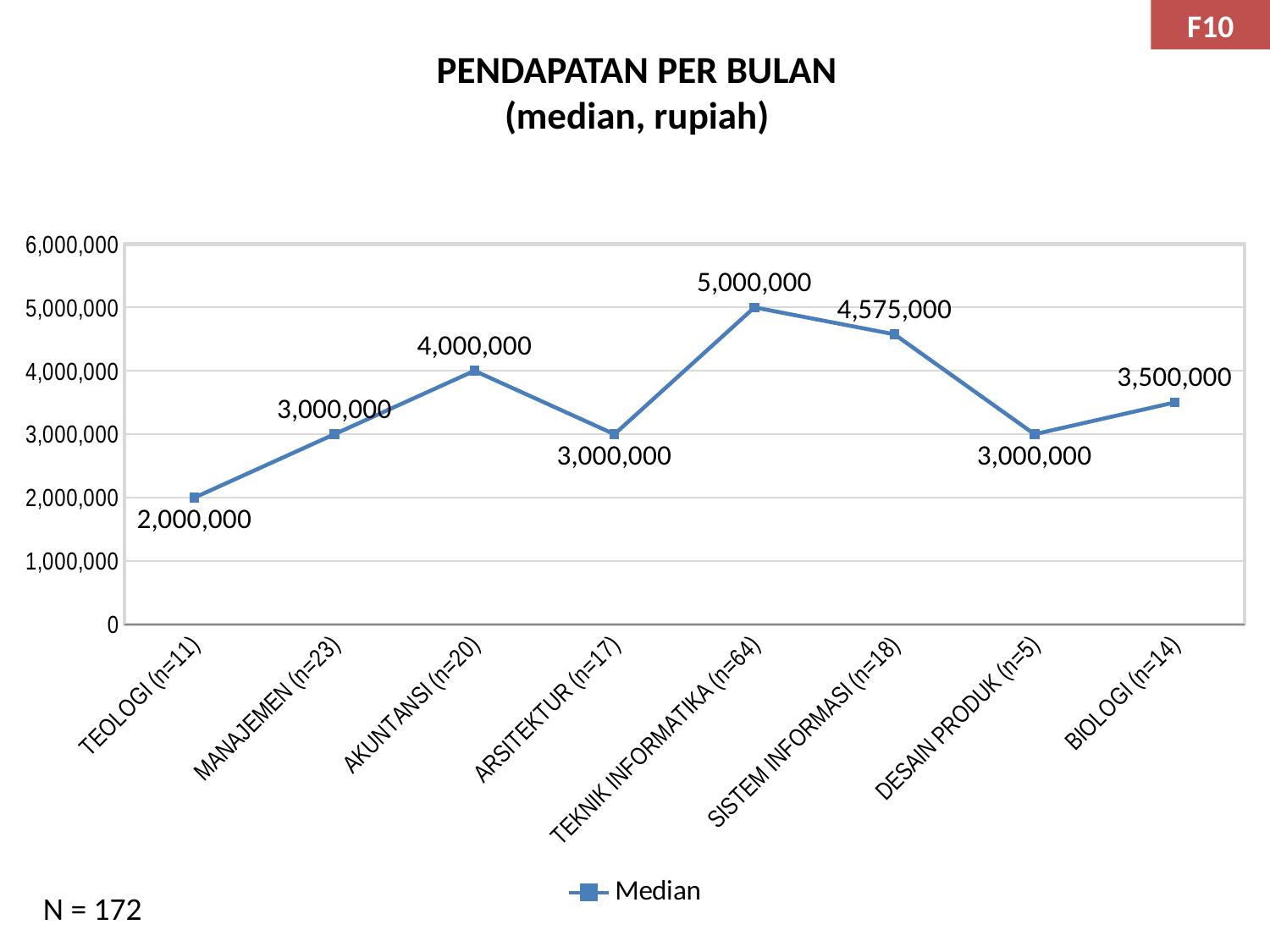
What kind of chart is shown on the slide? Line chart What is the median monthly income for SISTEM INFORMASI (n=18)? 4,575,000 How many categories are plotted on the chart? 8 What is the difference between the median for AKUNTANSI (n=20) and TEOLOGI (n=11)? 2,000,000 What is the median monthly income for TEKNIK INFORMATIKA (n=64)? 5,000,000 What is the name of the series shown in the legend? Median Which category has the lowest median monthly income? TEOLOGI (n=11) What is the median monthly income for TEOLOGI (n=11)? 2,000,000 Which category has the highest median monthly income? TEKNIK INFORMATIKA (n=64) What is the difference between the median for TEKNIK INFORMATIKA (n=64) and SISTEM INFORMASI (n=18)? 425,000 How many series does the legend list? 1 Which has a higher median monthly income, BIOLOGI (n=14) or DESAIN PRODUK (n=5)? BIOLOGI (n=14)